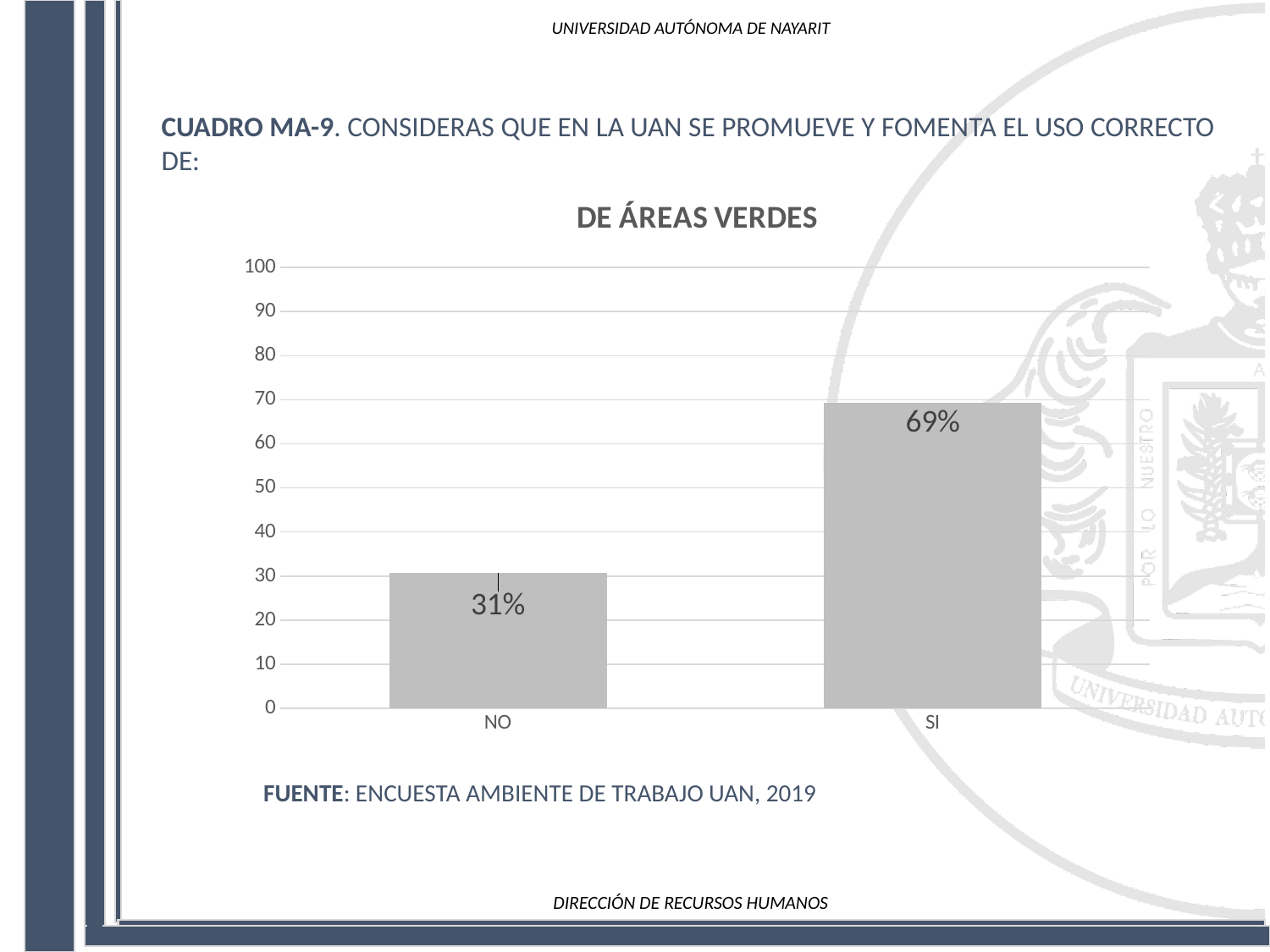
What is the maximum value shown on the y axis? 100 Is the value for SI greater or less than 60? greater Is the value for NO greater or less than 40? less Which category has the lowest value? NO What is the difference between the values for SI and NO? 38% Which category has the highest value? SI What is the value for NO? 31% What kind of chart is shown? bar chart What is the value for SI? 69% Which is larger, the value for NO or the value for SI? SI How many categories are shown on the x axis? 2 What is the title of the chart? DE ÁREAS VERDES